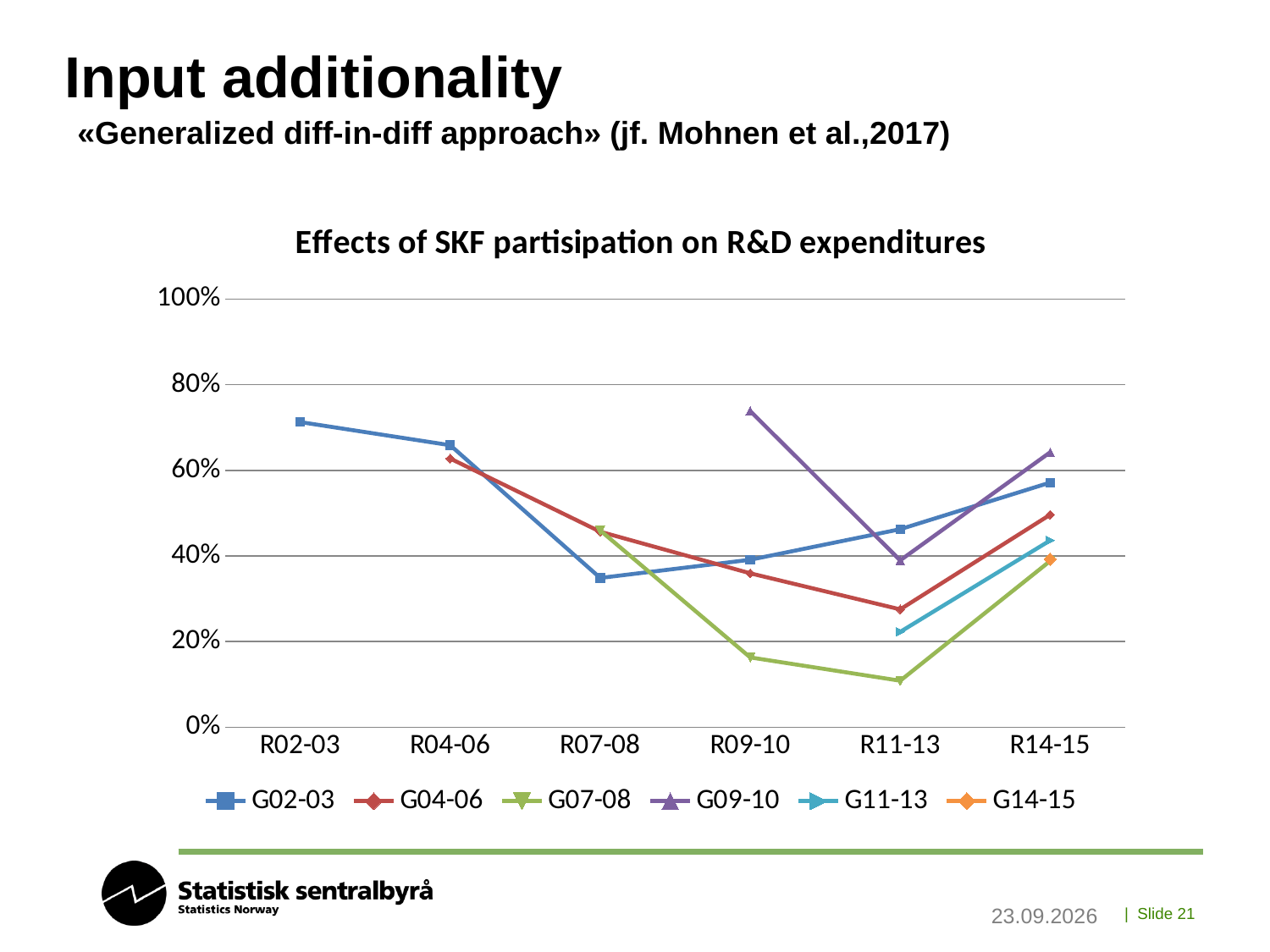
How many categories are shown on the x axis? 6 Is the value for G07-08 at R11-13 greater or less than 20%? less At R14-15, which series has the higher value, G09-10 or G02-03? G09-10 What kind of chart is shown on the slide? line chart Does the G02-03 series rise or fall from R02-03 to R07-08? fall What is the title of the chart? Effects of SKF partisipation on R&D expenditures Is the value for G09-10 at R09-10 greater or less than 60%? greater How many series does the legend list? 6 Is the value for G02-03 at R02-03 greater or less than 60%? greater Which series has the lowest value at R11-13? G07-08 Which series has the highest value at R14-15? G09-10